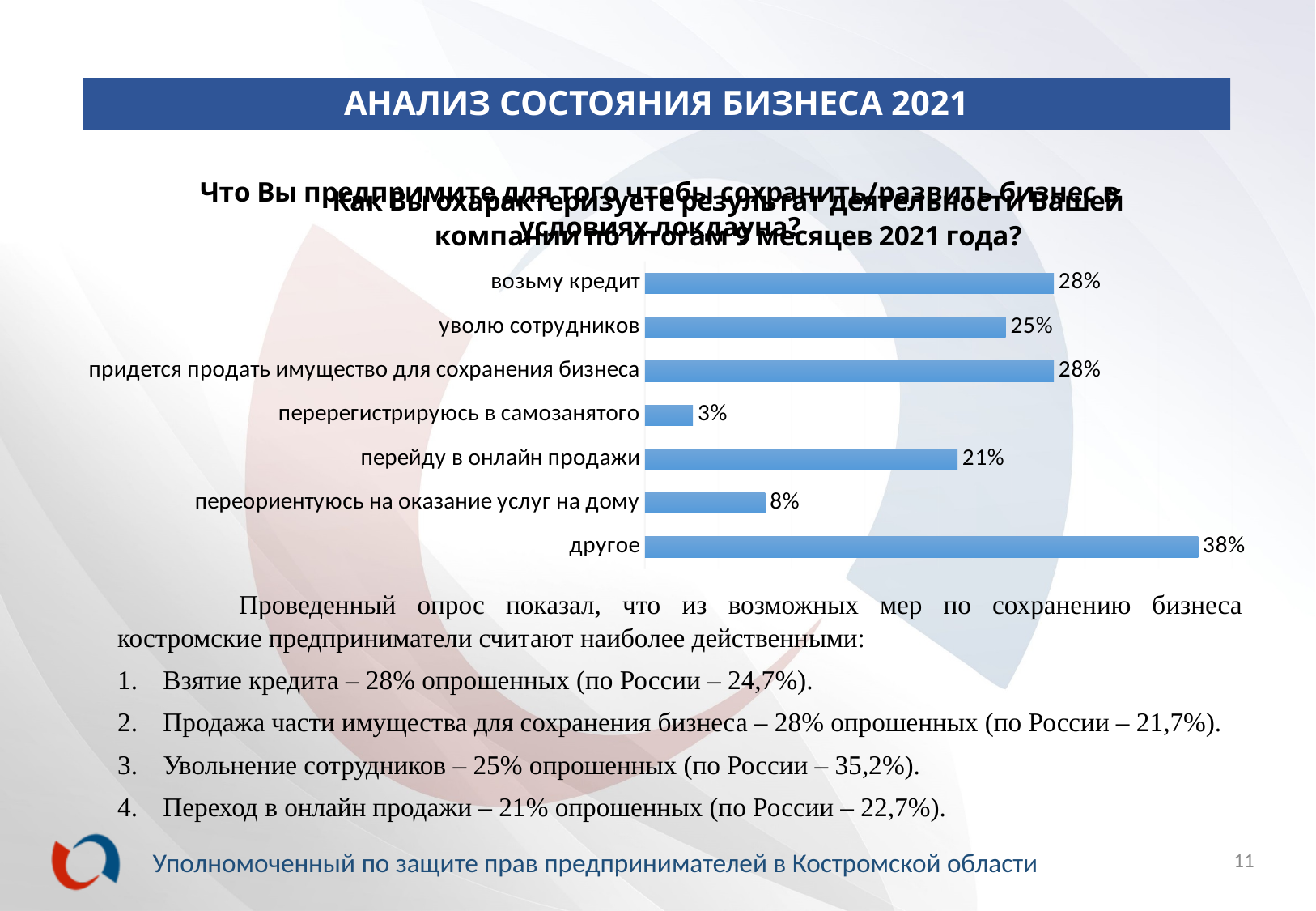
What is the difference between the values for "другое" and "возьму кредит"? 10% What is the value for "переориентуюсь на оказание услуг на дому"? 8% What is the value for "возьму кредит"? 28% What kind of chart is shown on the slide? bar chart What is the difference between the values for "уволю сотрудников" and "перейду в онлайн продажи"? 4% What is the value for "перейду в онлайн продажи"? 21% What is the value for "уволю сотрудников"? 25% Which category has the lowest value? перерегистрируюсь в самозанятого What is the value for "другое"? 38% Which category has the highest value? другое Which is larger: the value for "перейду в онлайн продажи" or the value for "переориентуюсь на оказание услуг на дому"? перейду в онлайн продажи How many categories are shown in the chart? 7